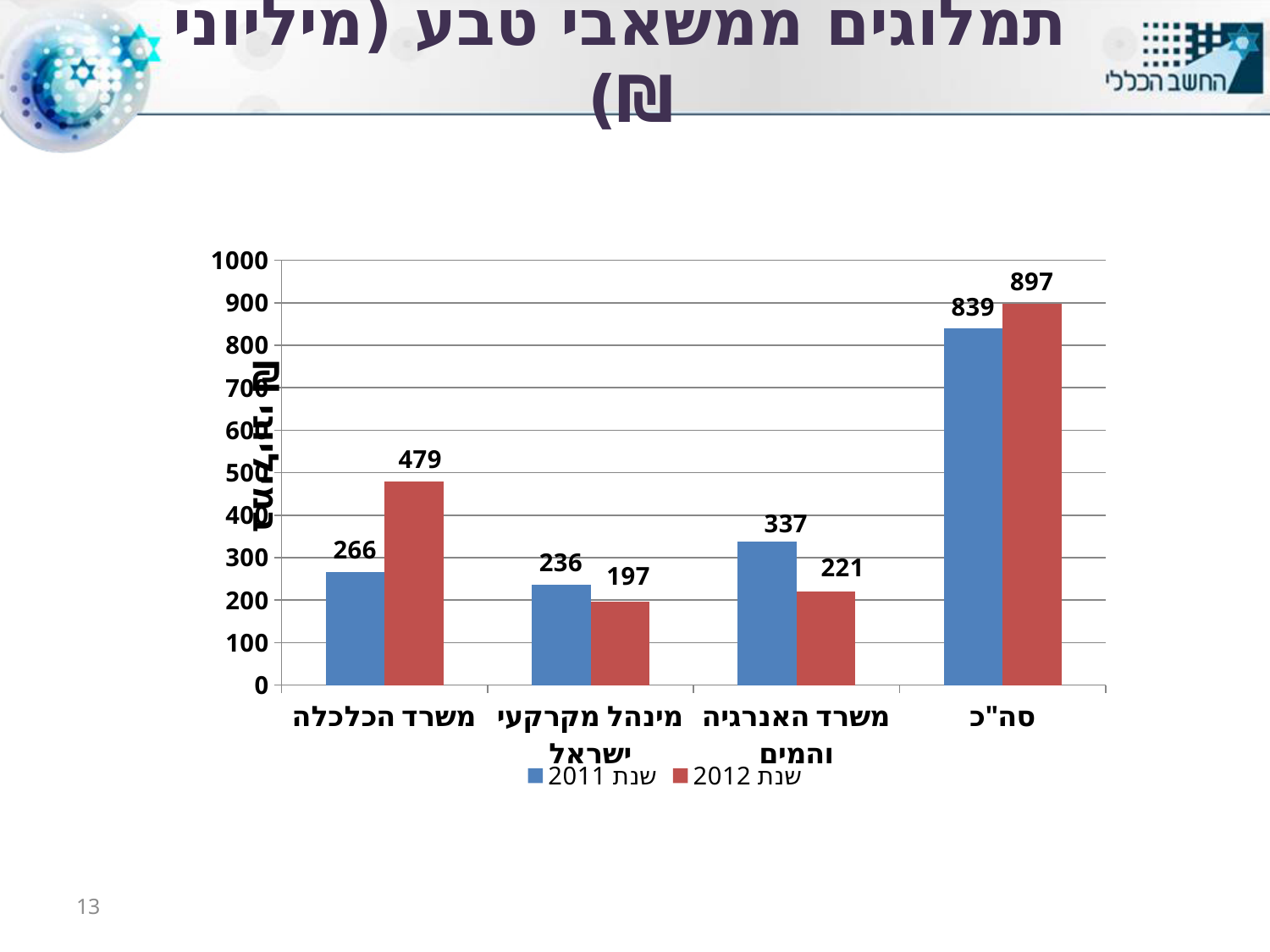
Excluding סה"כ, which category has the highest value in the שנת 2011 series? משרד האנרגיה והמים How many categories are shown on the x axis? 4 What is the difference between the שנת 2012 and שנת 2011 values for משרד הכלכלה? 213 For מינהל מקרקעי ישראל, which is larger: the שנת 2011 value or the שנת 2012 value? שנת 2011 What is the value for מינהל מקרקעי ישראל in the שנת 2012 series? 197 What is the value for סה"כ in the שנת 2011 series? 839 What is the value for משרד הכלכלה in the שנת 2012 series? 479 What is the value for משרד האנרגיה והמים in the שנת 2011 series? 337 What kind of chart is shown on the slide? bar chart Which category has the lowest value in the שנת 2012 series? מינהל מקרקעי ישראל How many series does the legend list? 2 What is the difference between the שנת 2011 and שנת 2012 values for משרד האנרגיה והמים? 116